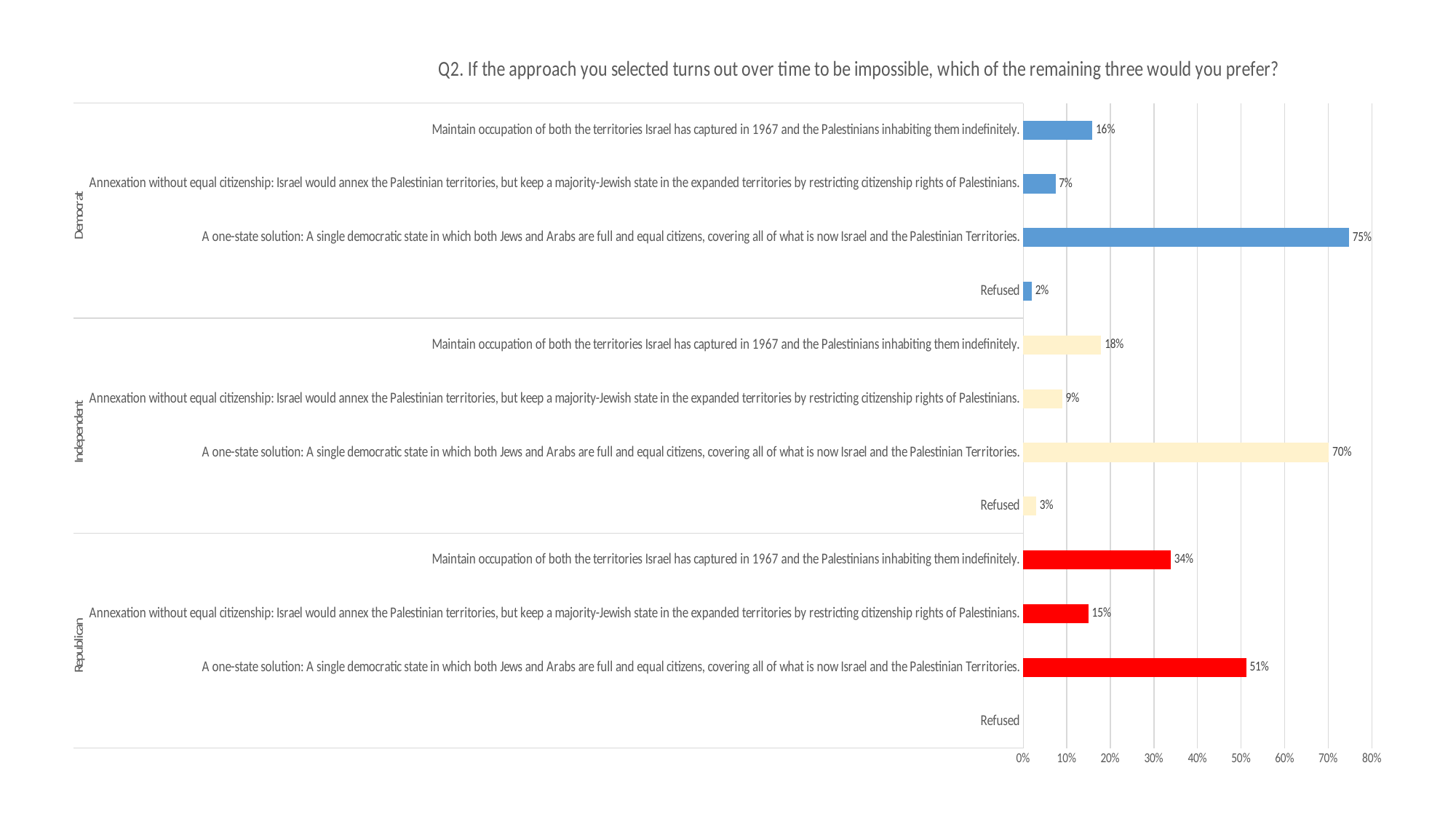
What percentage of Independents prefer annexation without equal citizenship? 9% Which party group has the highest value for the one-state solution? Democrat What is the difference between the Republican and Democrat values for maintaining occupation indefinitely? 18% What percentage of Republicans prefer to maintain occupation of the territories indefinitely? 34% How many party groups are shown on the chart? 3 Which option has the lowest value among Democrats? Refused Which is larger: the Republican value for annexation without equal citizenship or the Independent value for annexation without equal citizenship? Republican What is the difference between the Democrat and Republican values for the one-state solution? 24% What percentage of Independents refused to answer? 3% What kind of chart is shown on the slide? Bar chart What colour are the bars for the Republican group? Red What percentage of Democrats prefer the one-state solution? 75%